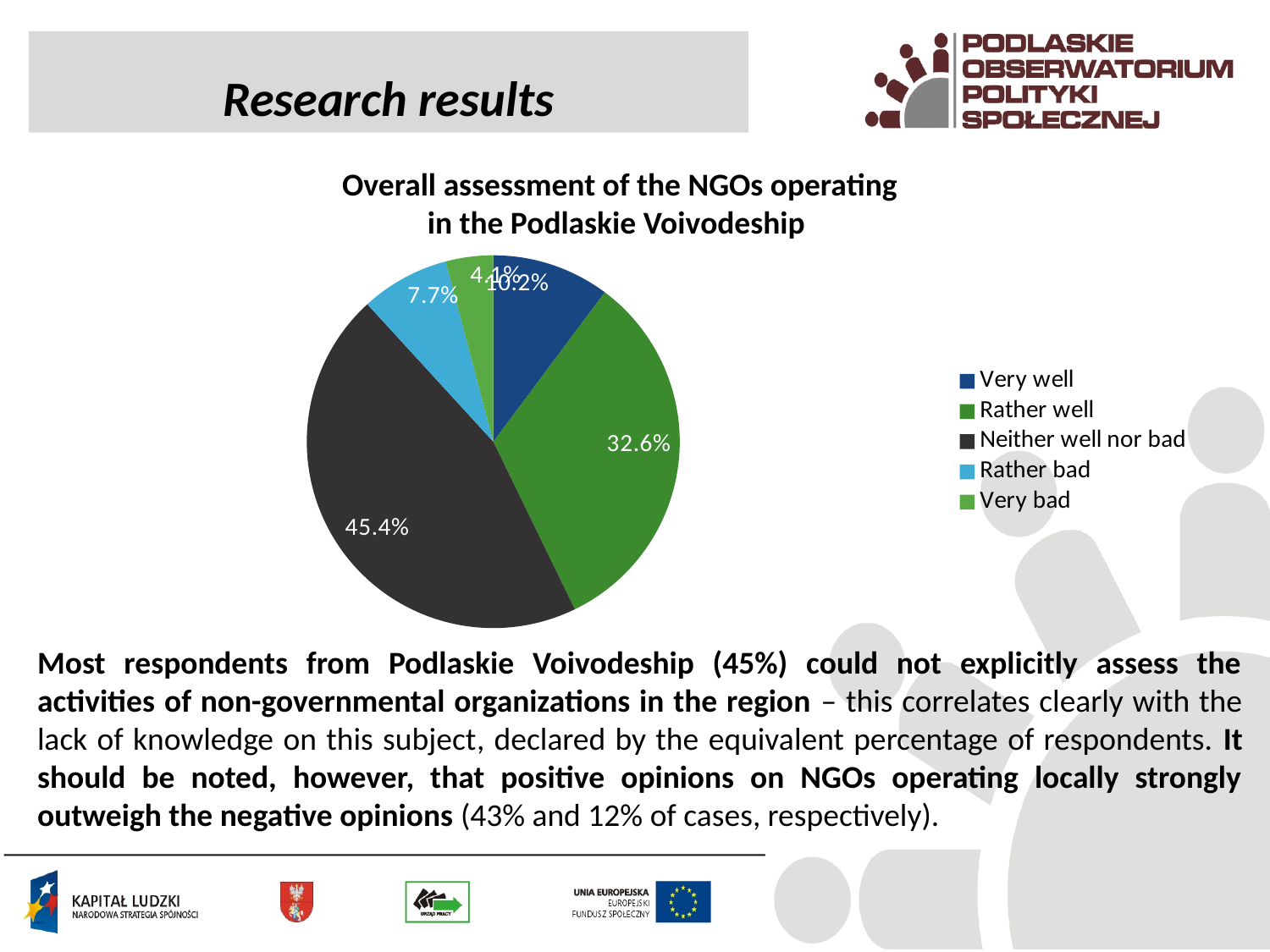
What percentage of respondents assessed the NGOs as 'Neither well nor bad'? 45.4% What percentage of respondents assessed the NGOs as 'Rather bad'? 7.7% Which category has the largest share of the pie? Neither well nor bad Which colour represents 'Rather bad' in the pie chart? Light blue What percentage of respondents assessed the NGOs as 'Very well'? 10.2% What is the title of the chart? Overall assessment of the NGOs operating in the Podlaskie Voivodeship What percentage of respondents assessed the NGOs as 'Rather well'? 32.6% What is the difference in percentage points between 'Neither well nor bad' and 'Rather well'? 12.8 Which category has the smallest share of the pie? Very bad Which is larger, the share for 'Rather well' or the share for 'Very well'? Rather well What kind of chart is shown on the slide? Pie chart How many categories does the legend of the pie chart list? 5